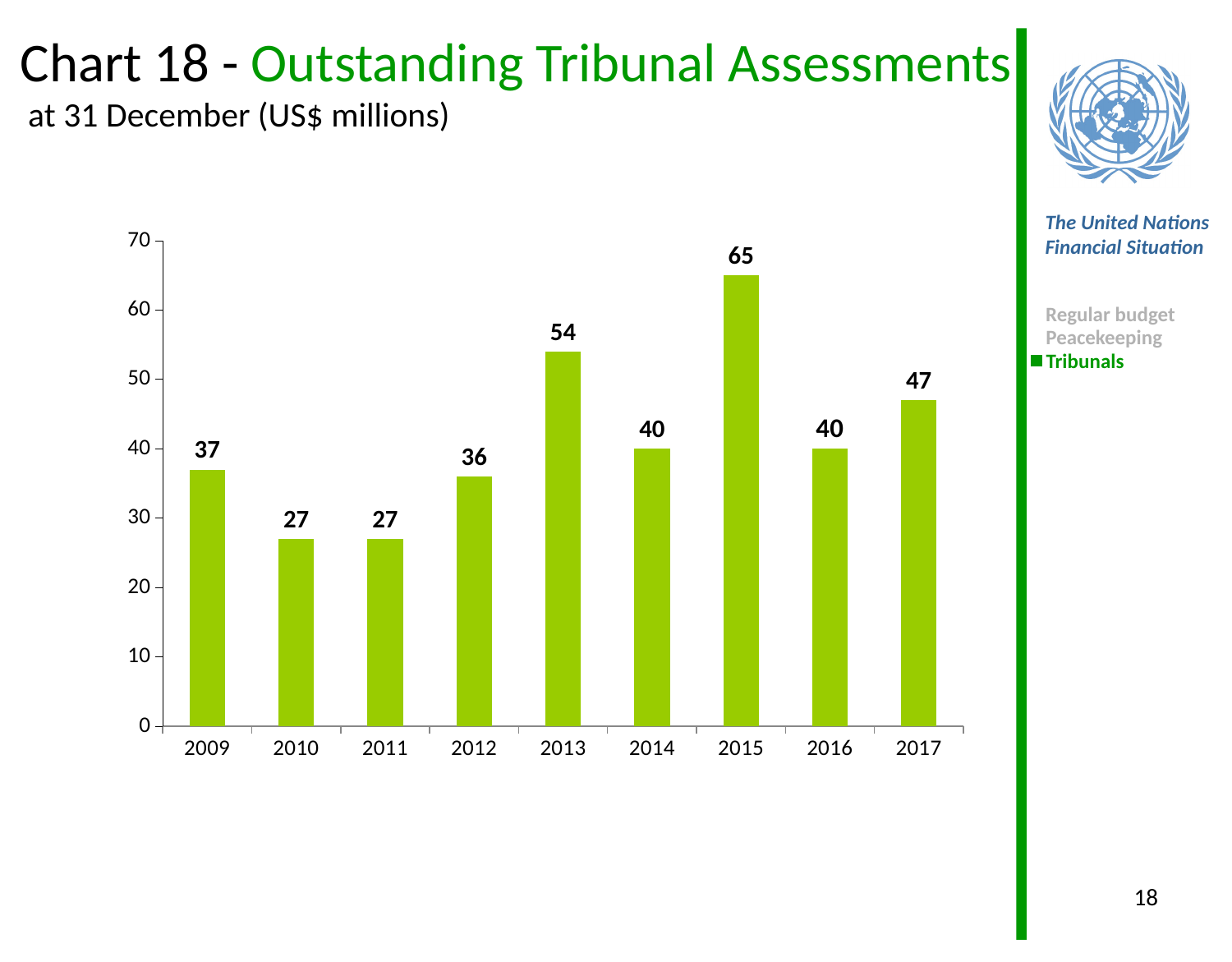
How many years are shown on the x axis? 9 What is the difference between the values for 2015 and 2014? 25 What is the highest value shown on the chart? 65 What is the lowest value shown on the chart? 27 What is the value of outstanding tribunal assessments for 2017? 47 In what units are the values on the chart expressed? US$ millions Which is larger, the value for 2012 or the value for 2014? 2014 What is the value of outstanding tribunal assessments for 2009? 37 What kind of chart is shown on the slide? Bar chart Which year has the highest outstanding tribunal assessments? 2015 What is the value of outstanding tribunal assessments for 2013? 54 What is the difference between the values for 2017 and 2016? 7